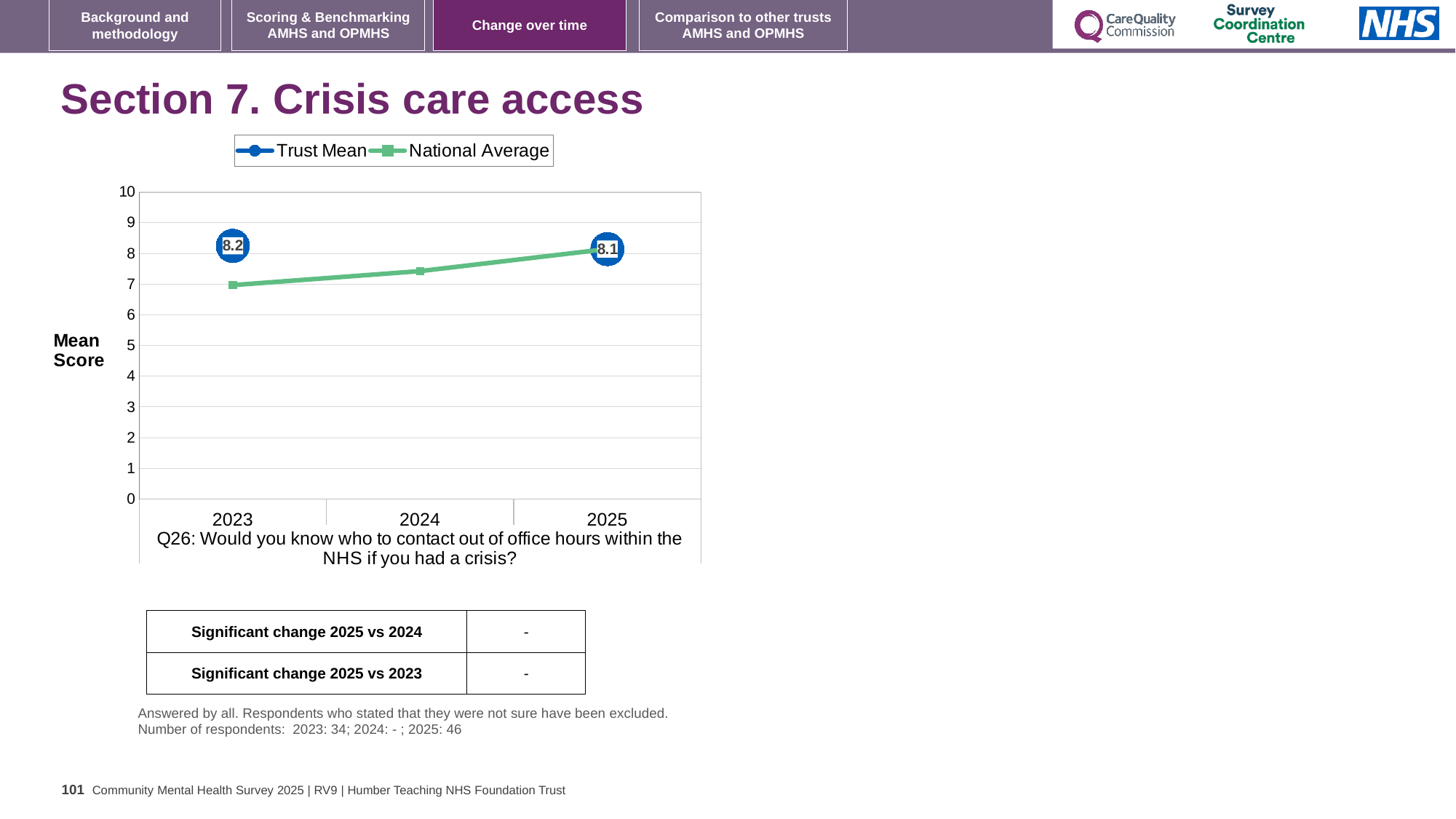
What is the Trust Mean value for 2023? 8.2 What kind of chart is shown on the slide? Line chart How many years are shown on the x axis of the chart? 3 Does the National Average rise or fall from 2023 to 2025? Rise Is the National Average value for 2024 greater or less than 8? less Which year has the higher Trust Mean, 2023 or 2025? 2023 How many series does the chart legend list? 2 What is the difference between the Trust Mean in 2023 and the Trust Mean in 2025? 0.1 Is the National Average value for 2025 greater or less than 7? greater Is the National Average value for 2023 greater or less than 8? less What is the label on the y axis of the chart? Mean Score What is the Trust Mean value for 2025? 8.1